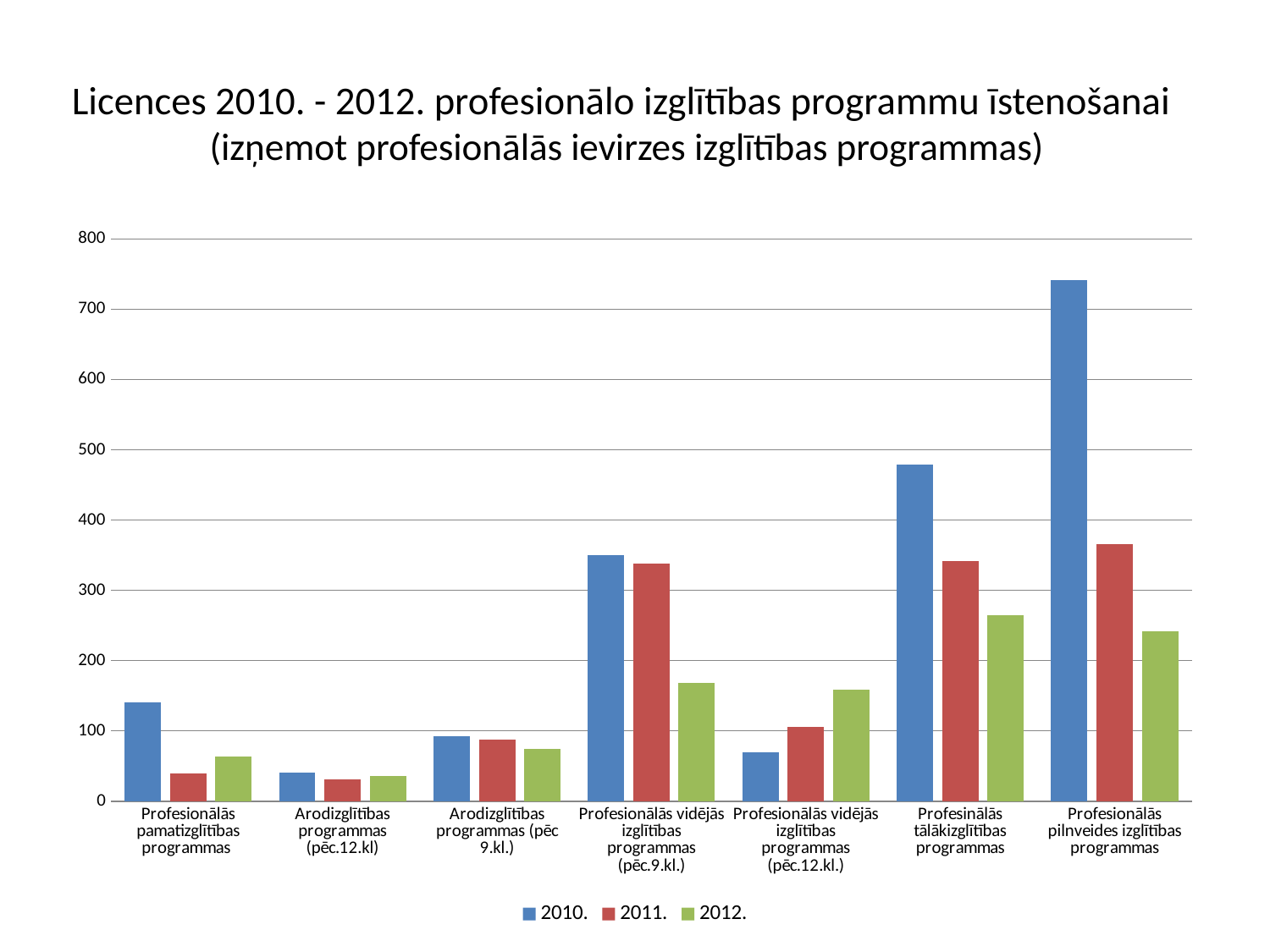
Is the 2011. value for Profesionālās vidējās izglītības programmas (pēc.9.kl.) greater or less than 300? greater Is the 2010. value for Profesinālās tālākizglītības programmas greater or less than 400? greater Is the 2010. value for Profesionālās pilnveides izglītības programmas greater or less than 700? greater Which category has the lowest value for the 2011. series? Arodizglītības programmas (pēc.12.kl) What kind of chart is shown on the slide? bar chart For Profesionālās pamatizglītības programmas, which series has the larger value, 2010. or 2011.? 2010. For Profesionālās vidējās izglītības programmas (pēc.12.kl.), which series has the larger value, 2010. or 2012.? 2012. Which series is shown in green in the legend? 2012. Which category has the highest value for the 2010. series? Profesionālās pilnveides izglītības programmas How many series does the legend list? 3 How many categories are shown on the x axis? 7